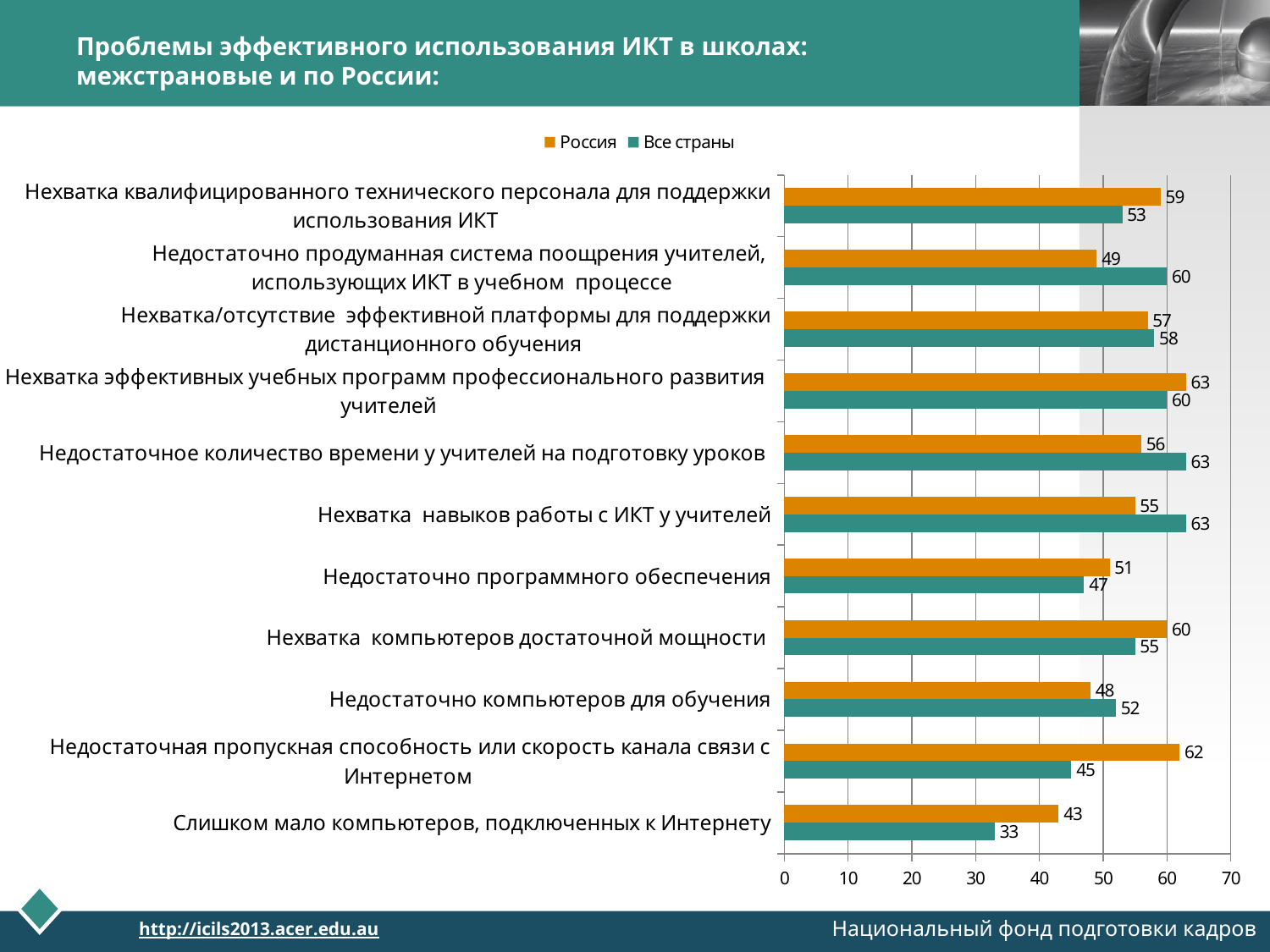
What is the value for Россия for «Недостаточная пропускная способность или скорость канала связи с Интернетом»? 62 How many series does the legend list? 2 How many categories are shown in the chart? 11 What is the difference between Россия and Все страны for «Недостаточная пропускная способность или скорость канала связи с Интернетом»? 17 Which colour represents the series Россия in the chart? Orange Which category has the highest value for Россия? Нехватка эффективных учебных программ профессионального развития учителей Is the value for Все страны for «Слишком мало компьютеров, подключенных к Интернету» greater or less than 40? less What is the value for Россия for «Слишком мало компьютеров, подключенных к Интернету»? 43 For «Недостаточно продуманная система поощрения учителей, использующих ИКТ в учебном процессе», which is larger: Россия or Все страны? Все страны Which category has the lowest value for Все страны? Слишком мало компьютеров, подключенных к Интернету What kind of chart is shown on the slide? Bar chart What is the value for Все страны for «Недостаточно программного обеспечения»? 47